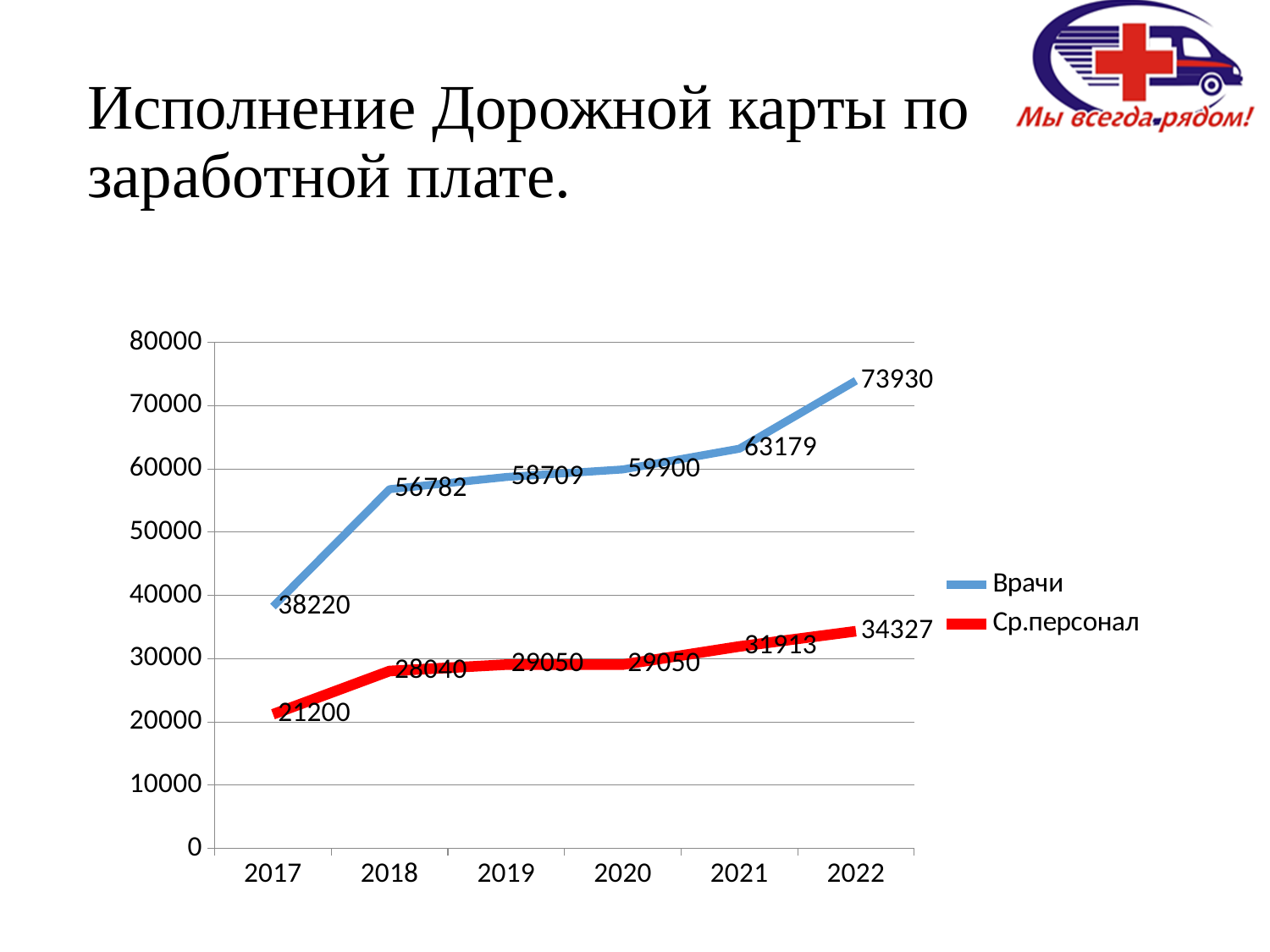
Which is larger: the Врачи value in 2018 or the Врачи value in 2021? 2021 Is the value for Ср.персонал in 2021 greater or less than 30000? greater Do the values for Врачи rise or fall from 2017 to 2022? rise How many series does the legend list? 2 What is the difference between the Врачи and Ср.персонал values in 2022? 39603 What is the value for Врачи in 2020? 59900 What is the value for Врачи in 2017? 38220 What is the value for Ср.персонал in 2022? 34327 In which year is the value for Ср.персонал lowest? 2017 How many years are shown on the x axis? 6 In which year is the value for Врачи highest? 2022 What kind of chart is shown on the slide? line chart